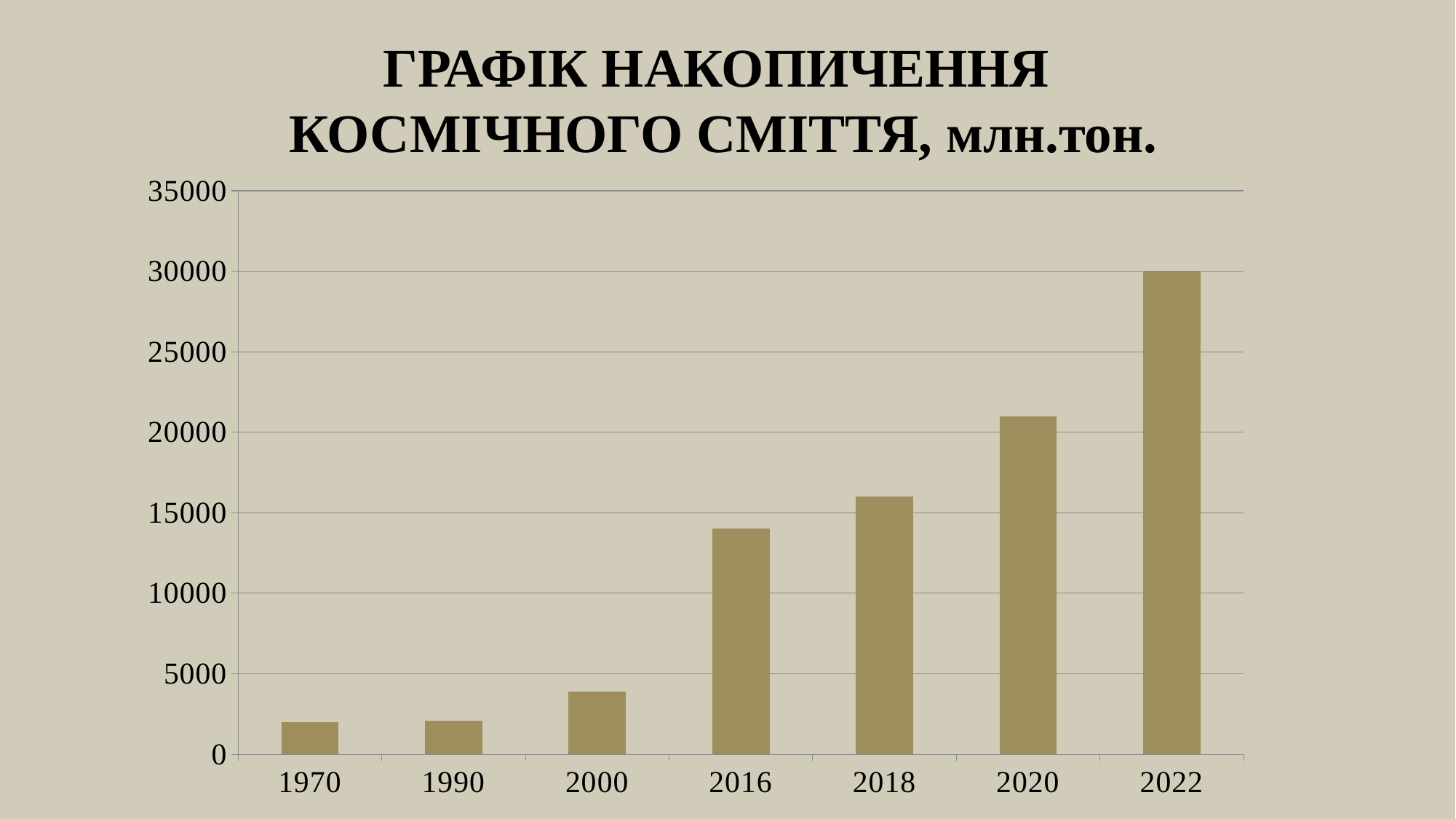
Is the value for 2018 greater or less than 15000? greater Is the value for 2020 greater or less than 20000? greater Is the value for 1970 greater or less than 5000? less How many years (categories) are shown on the x axis of the chart? 7 Which is larger, the value for 2018 or the value for 2020? 2020 What is the value for 2022 in the chart? 30000 What unit is given in the chart title? млн.тон. Which year has the highest value in the chart? 2022 Do the values rise or fall from 1970 to 2022 along the x axis? rise What kind of chart is shown on the slide? bar chart